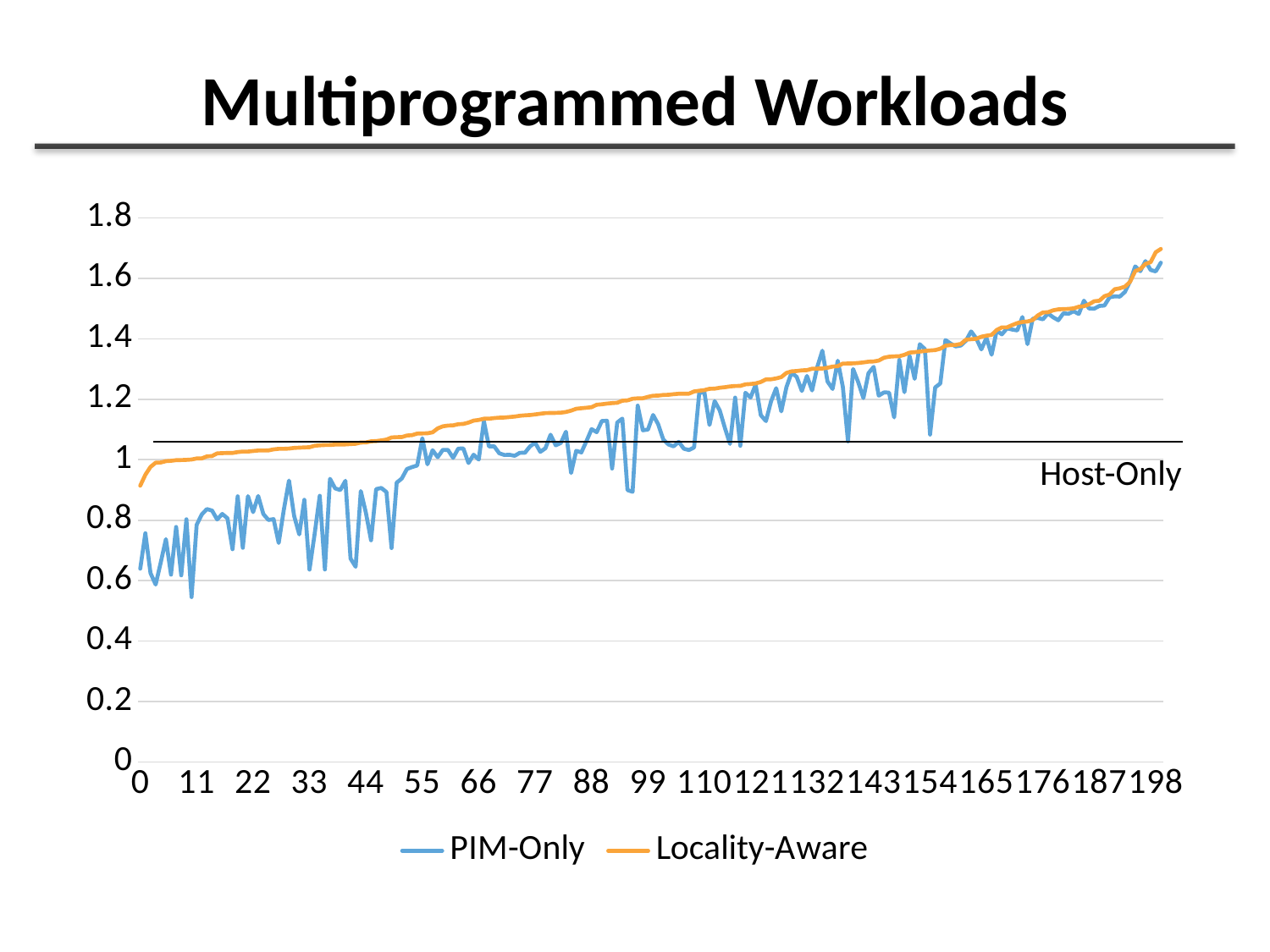
Is the value of the Locality-Aware series at x = 198 greater or less than 1.6? greater At x = 33, which series has the higher value, PIM-Only or Locality-Aware? Locality-Aware What label is attached to the horizontal reference line in the chart? Host-Only Is the value of the PIM-Only series at x = 0 greater or less than 0.8? less What is the title of the chart? Multiprogrammed Workloads Does the Locality-Aware series rise or fall as the x axis increases from 0 to 198? rise What kind of chart is shown on the slide? line chart Is the value of the Locality-Aware series at x = 0 greater or less than 1? less At x = 0, which series has the higher value, PIM-Only or Locality-Aware? Locality-Aware How many series does the legend list? 2